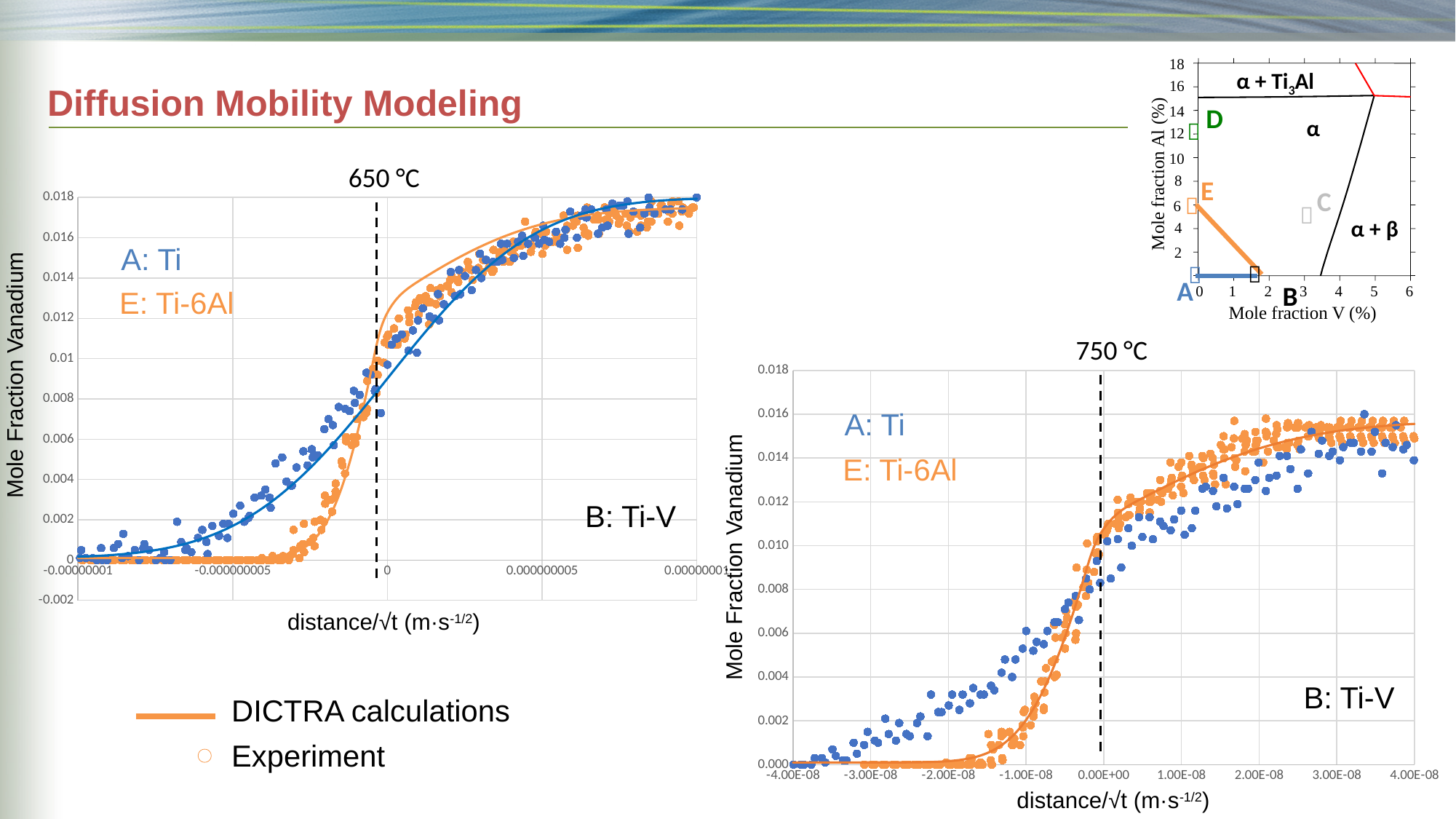
Which colour represents the E: Ti-6Al series in the charts? orange In the 750 °C chart, at distance/√t = 0.00E+00, is the value for E: Ti-6Al greater or less than 0.006? greater In the 750 °C chart, at distance/√t = -1.00E-08, which series has the higher Mole Fraction Vanadium, A: Ti or E: Ti-6Al? A: Ti In the 750 °C chart, at distance/√t = 3.00E-08, is the value for E: Ti-6Al greater or less than 0.014? greater In the 650 °C chart, at distance/√t = -0.000000005, which series has the higher value, A: Ti or E: Ti-6Al? A: Ti In the 750 °C chart, at distance/√t = 0.00E+00, is the value for A: Ti greater or less than 0.012? less What temperature is shown as the title of the left chart? 650 °C How many series (alloys) are plotted in the 750 °C chart? 2 In the 650 °C chart, do the values for A: Ti rise or fall from left to right along the x axis? rise What kind of chart is the 650 °C chart? scatter chart In the 750 °C chart, do the Mole Fraction Vanadium values rise or fall as distance/√t increases? rise